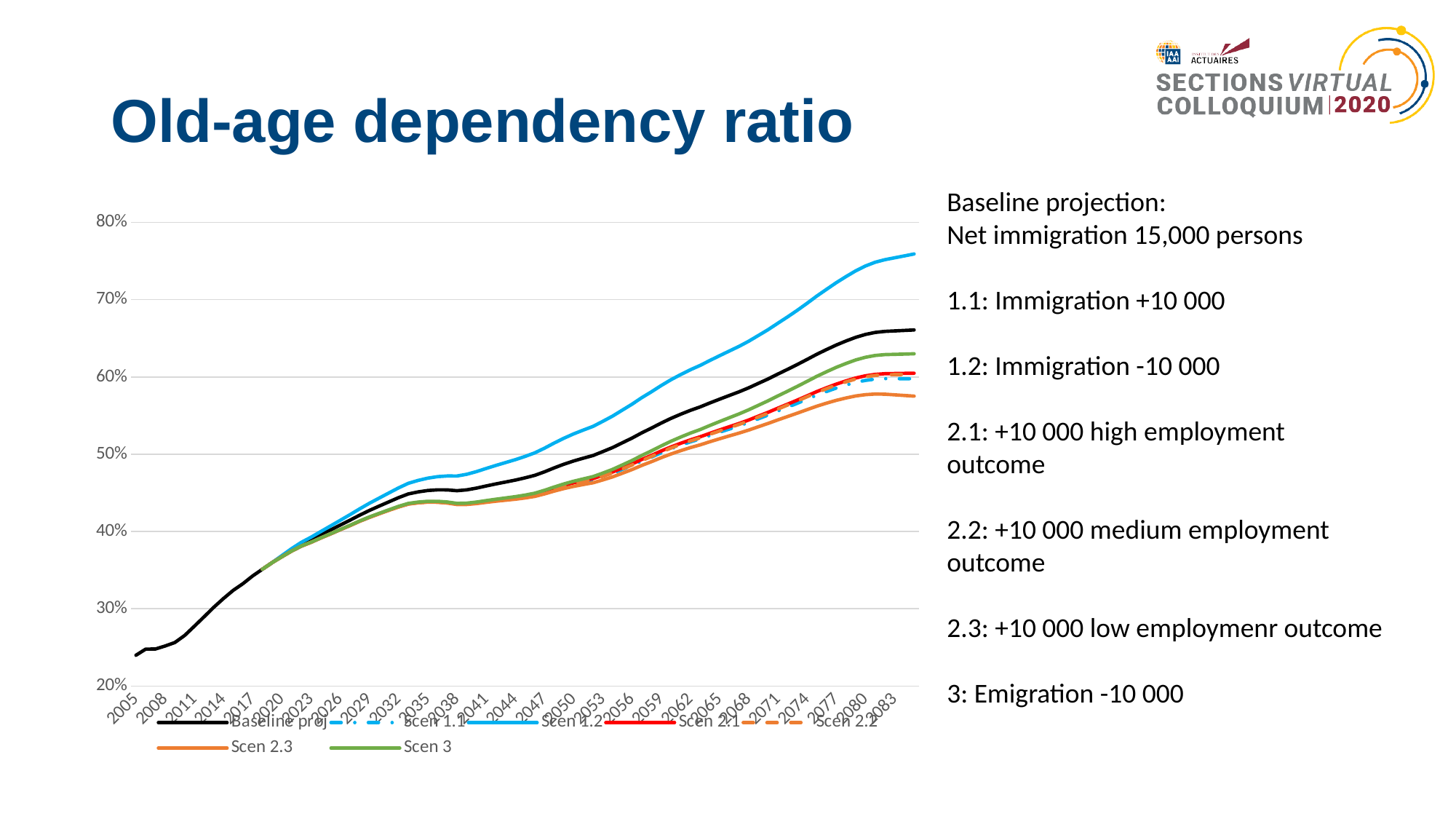
Which series has the lowest value at 2083? Scen 2.3 Does the Baseline proj series rise or fall from 2005 to 2083? Rise Which series is drawn in black in the chart? Baseline proj At 2083, which is larger: Scen 1.2 or Baseline proj? Scen 1.2 How many series does the chart legend list? 7 At 2083, which is larger: Baseline proj or Scen 3? Baseline proj Is the value for Scen 1.2 at 2083 greater or less than 70%? greater Is the value for Baseline proj at 2005 greater or less than 30%? less What is the title of the slide containing the chart? Old-age dependency ratio Which series has the highest value at 2083? Scen 1.2 Is the value for Scen 2.3 at 2083 greater or less than 60%? less What kind of chart is shown on the slide? Line chart